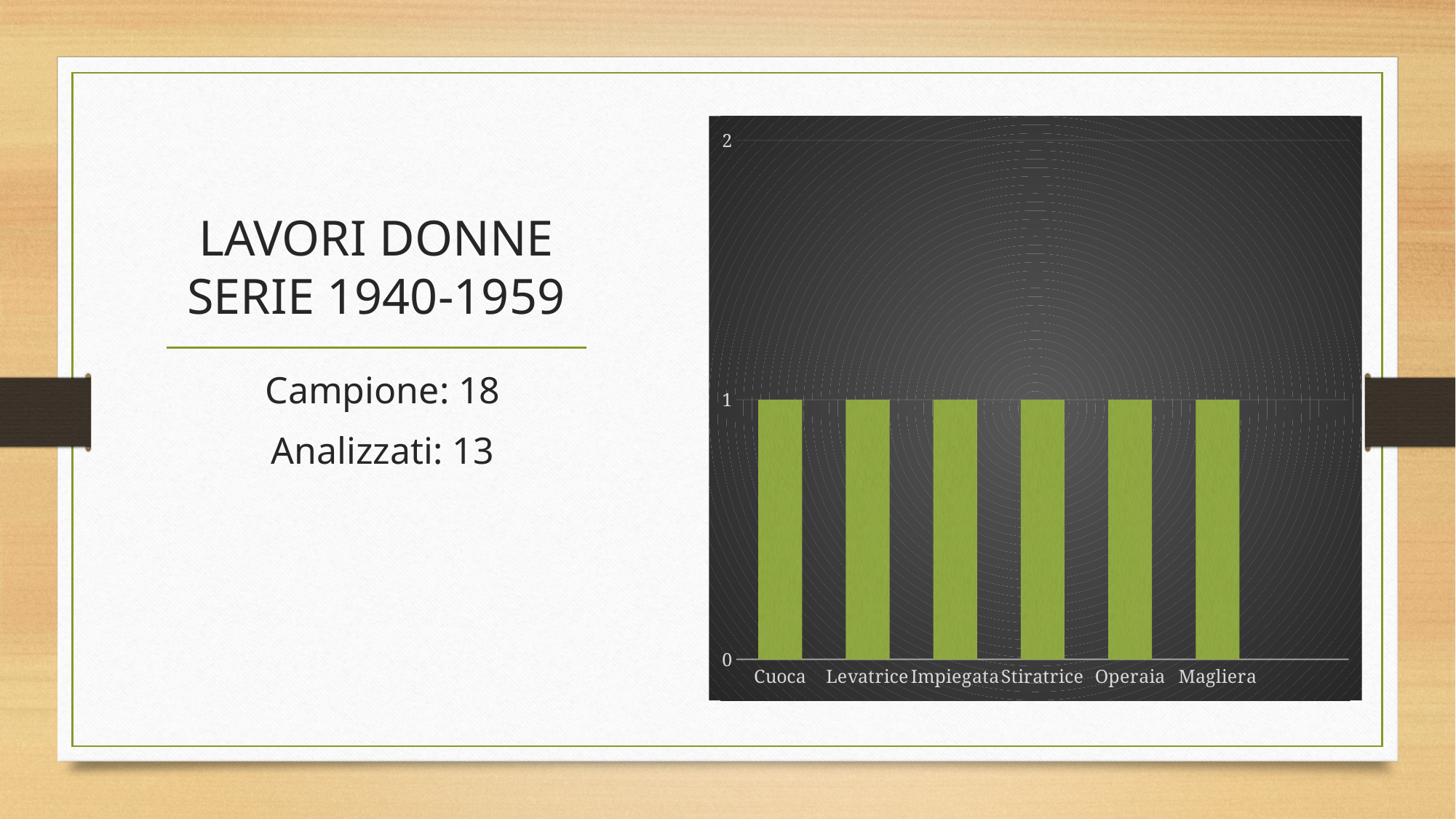
How many categories are shown on the x axis of the chart? 6 Is the value for Operaia greater or less than 2? less What kind of chart is shown on the slide? bar chart What is the value for Stiratrice? 1 What is the value for Magliera? 1 What is the value for Cuoca? 1 What colour are the bars in the chart? green What is the highest value shown on the vertical axis? 2 What is the difference between the values for Impiegata and Operaia? 0 Which category is listed first on the x axis? Cuoca What is the value for Levatrice? 1 Do the values rise, fall, or stay the same across the categories from Cuoca to Magliera? stay the same